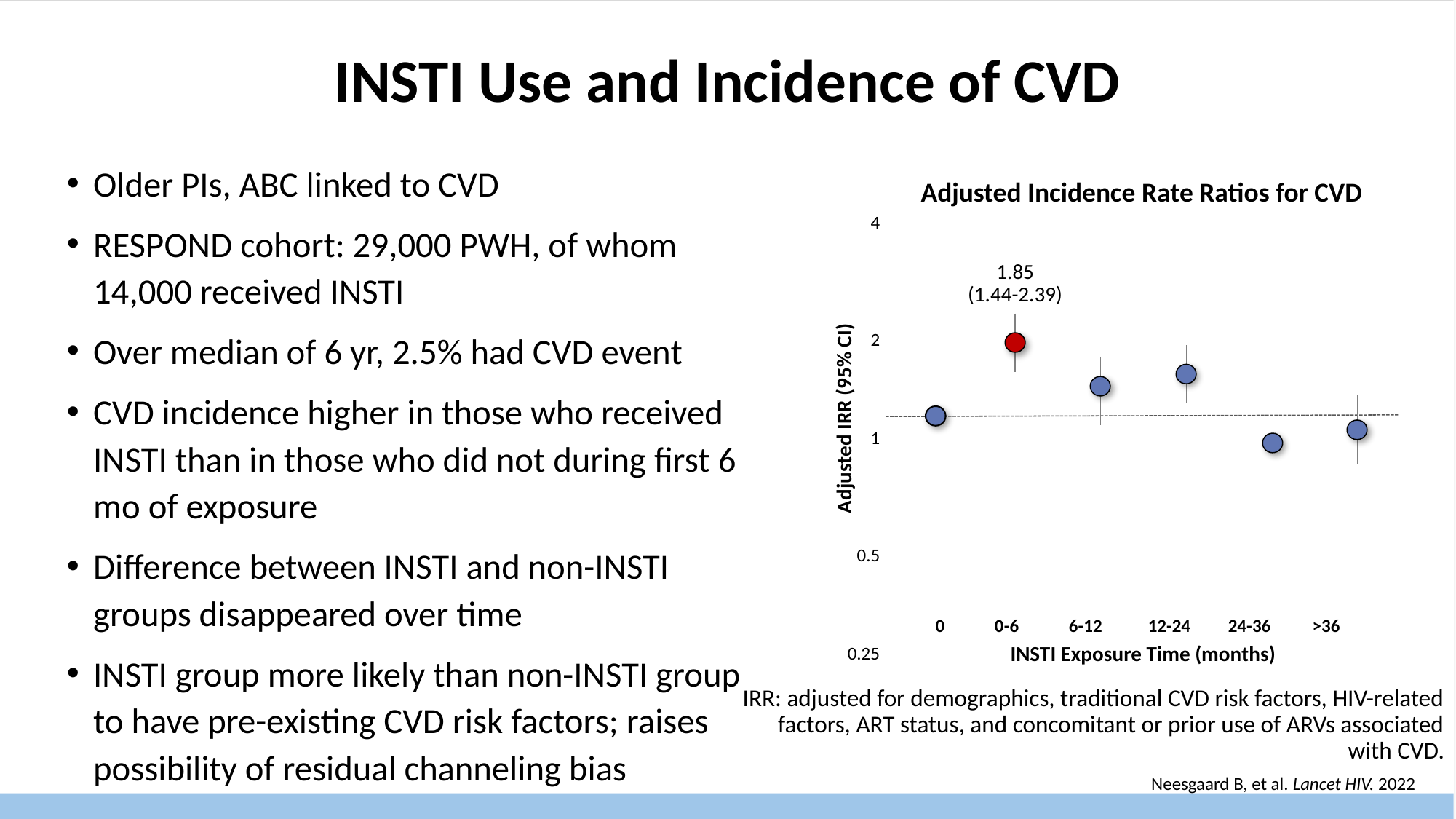
What is the title of the chart? Adjusted Incidence Rate Ratios for CVD What is the adjusted IRR value labelled for the 0-6 months INSTI exposure category? 1.85 Which INSTI exposure time category has the highest adjusted IRR? 0-6 Is the adjusted IRR for the 12-24 months category greater or less than 1? greater What 95% confidence interval is printed for the 0-6 months exposure point? (1.44-2.39) What is the label of the x axis of the chart? INSTI Exposure Time (months) Which has the larger adjusted IRR, the 0-6 months category or the 24-36 months category? 0-6 Is the adjusted IRR for the 24-36 months category greater or less than 2? less Is the adjusted IRR for the 0-6 months category greater or less than 1? greater What kind of chart is used to show the adjusted incidence rate ratios? Scatter (dot) plot with error bars How many INSTI exposure time categories are plotted on the x axis? 6